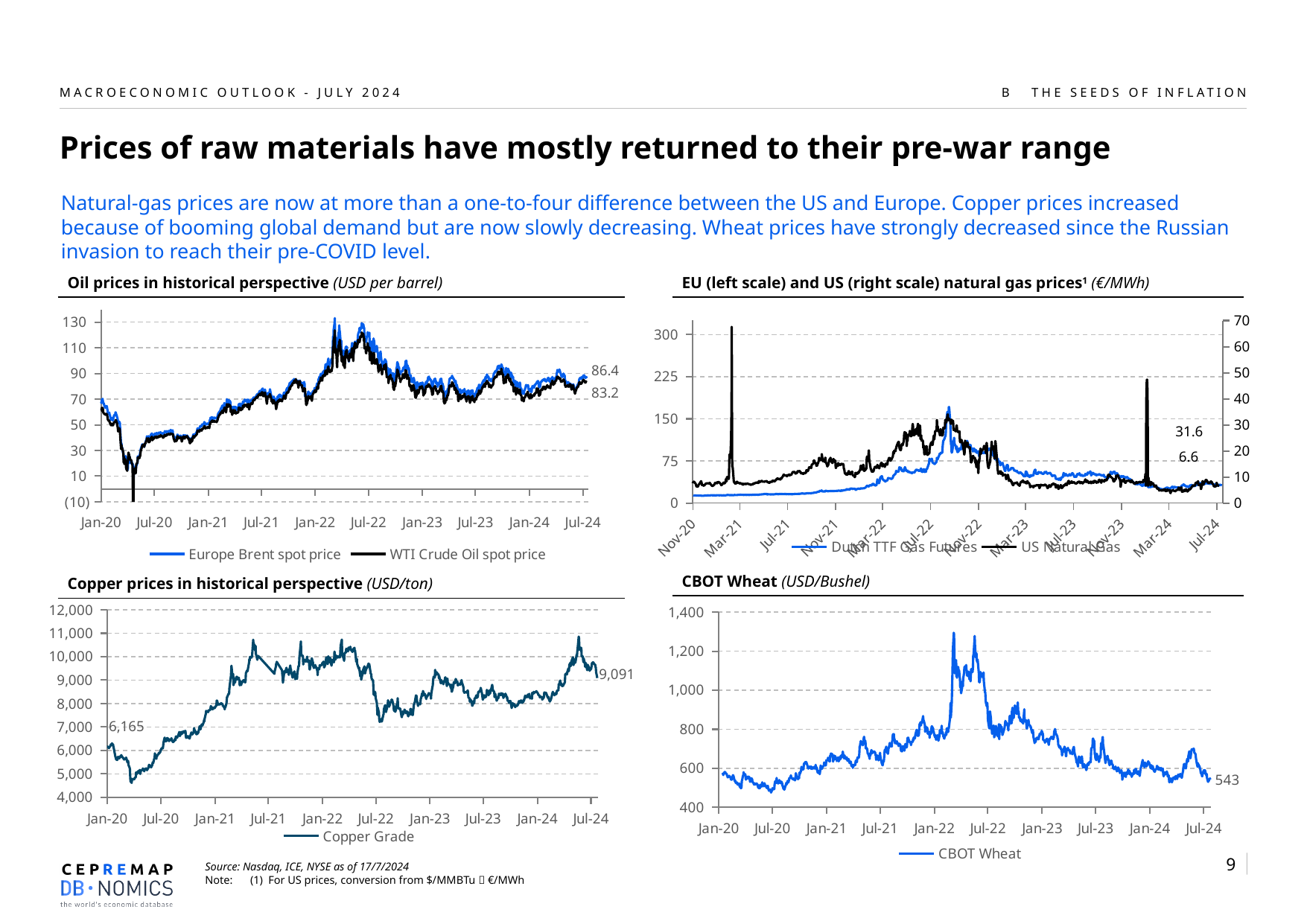
In the 'Oil prices in historical perspective' chart, is the peak of the Brent price in 2022 greater or less than 110? greater In the 'Copper prices in historical perspective' chart, what is the difference between the latest labelled value (9,091) and the starting labelled value (6,165)? 2,926 In the 'CBOT Wheat' chart, is the peak value in 2022 greater or less than 1,200? greater In the 'Oil prices in historical perspective' chart, what is the difference between the latest labelled Brent and WTI values? 3.2 In the 'Oil prices in historical perspective' chart, what is the latest labelled value for the Europe Brent spot price? 86.4 In the 'Oil prices in historical perspective' chart, what is the latest labelled value for the WTI Crude Oil spot price? 83.2 In the 'EU (left scale) and US (right scale) natural gas prices' chart, what is the latest labelled value for US Natural Gas? 6.6 In the 'CBOT Wheat' chart, what is the latest labelled value? 543 In the 'Oil prices in historical perspective' chart, which series has the higher latest labelled value, Europe Brent or WTI Crude Oil? Europe Brent spot price In the 'Oil prices in historical perspective' chart, how many series does the legend list? 2 In the 'Copper prices in historical perspective' chart, what is the latest labelled value? 9,091 In the 'EU (left scale) and US (right scale) natural gas prices' chart, what is the latest labelled value for Dutch TTF Gas Futures? 31.6